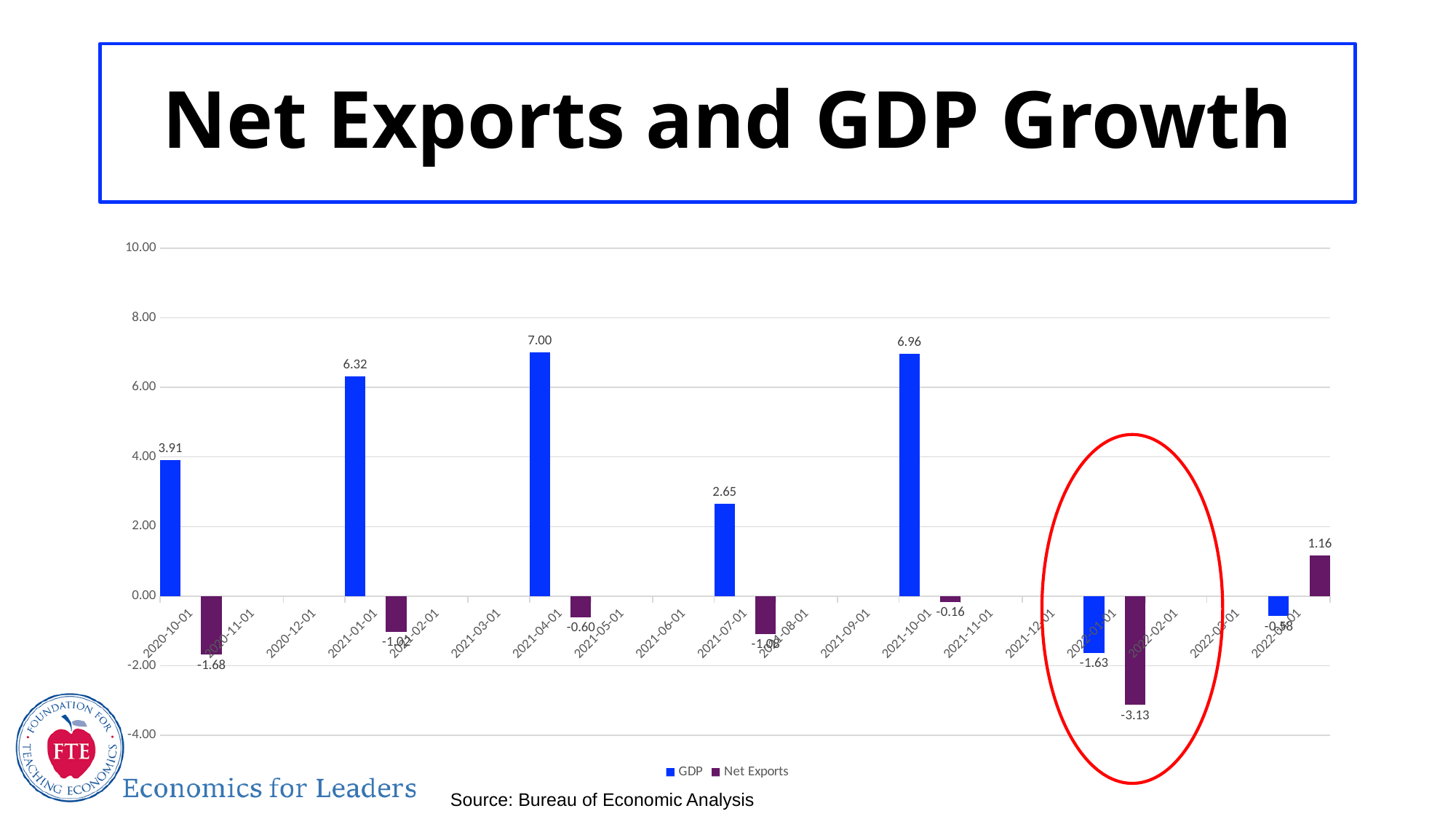
Which date has the lowest Net Exports value? 2022-01-01 How many series does the legend list? 2 What is the title of the slide? Net Exports and GDP Growth What is the GDP value for 2022-01-01? -1.63 What is the GDP value for 2021-04-01? 7.00 What kind of chart is shown on the slide? Bar chart What is the Net Exports value for 2022-04-01? 1.16 Which date has the highest GDP value? 2021-04-01 What is the difference between the GDP values for 2021-10-01 and 2021-01-01? 0.64 Which is larger, the GDP value for 2020-10-01 or for 2021-07-01? 2020-10-01 What is the Net Exports value for 2022-01-01? -3.13 What is the GDP value for 2020-10-01? 3.91